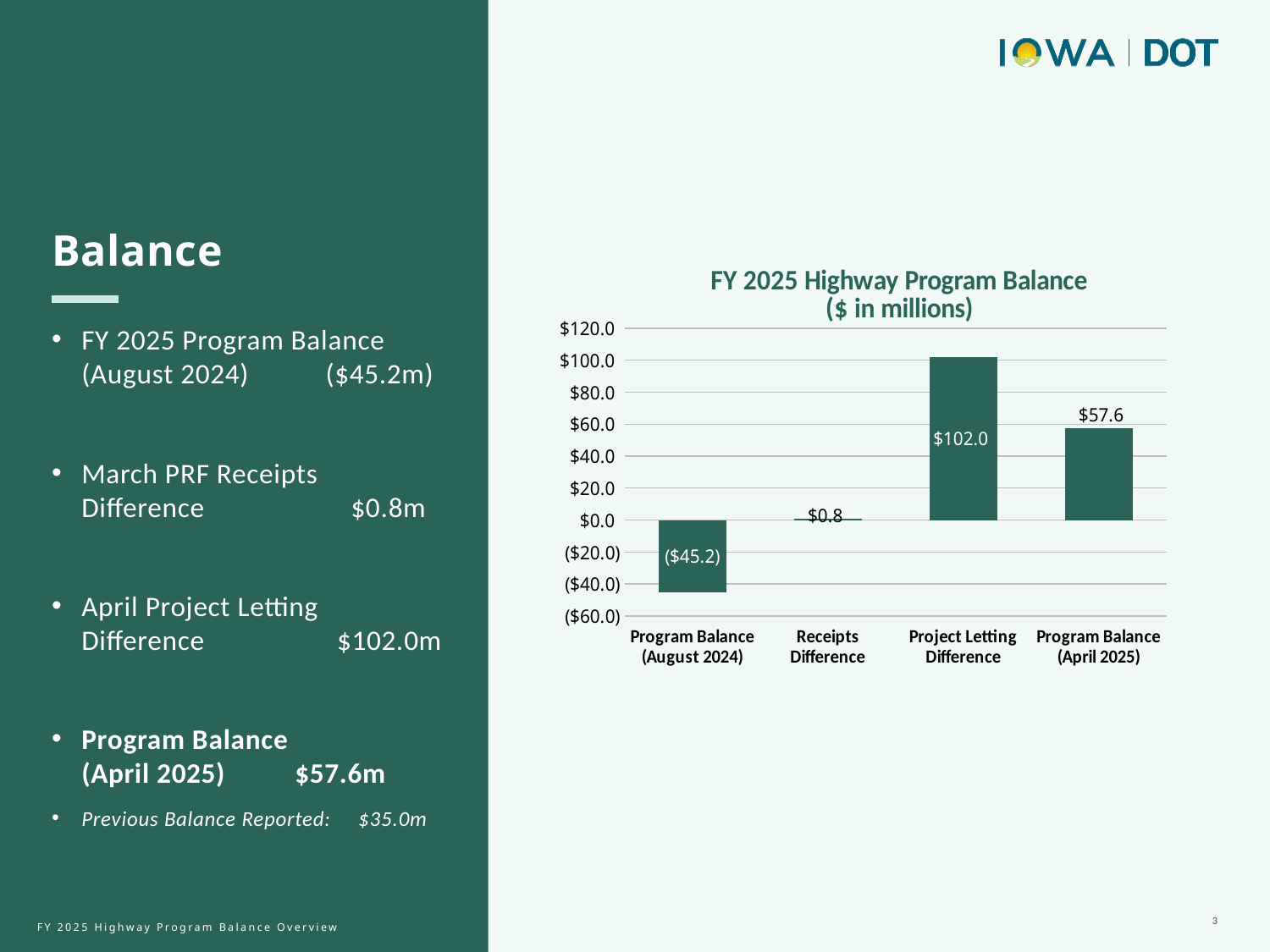
What is the title of the chart? FY 2025 Highway Program Balance ($ in millions) What is the difference between Project Letting Difference and Program Balance (April 2025)? $44.4 Which category has the lowest value? Program Balance (August 2024) What is the value for Program Balance (April 2025)? $57.6 What is the value for Project Letting Difference? $102.0 Which is larger, Project Letting Difference or Program Balance (April 2025)? Project Letting Difference How many categories are plotted in the chart? 4 What type of chart is shown on the slide? bar chart Is the value for Project Letting Difference greater or less than $100.0? greater What is the value for Receipts Difference? $0.8 What is the value for Program Balance (August 2024)? ($45.2) Which category has the highest value? Project Letting Difference